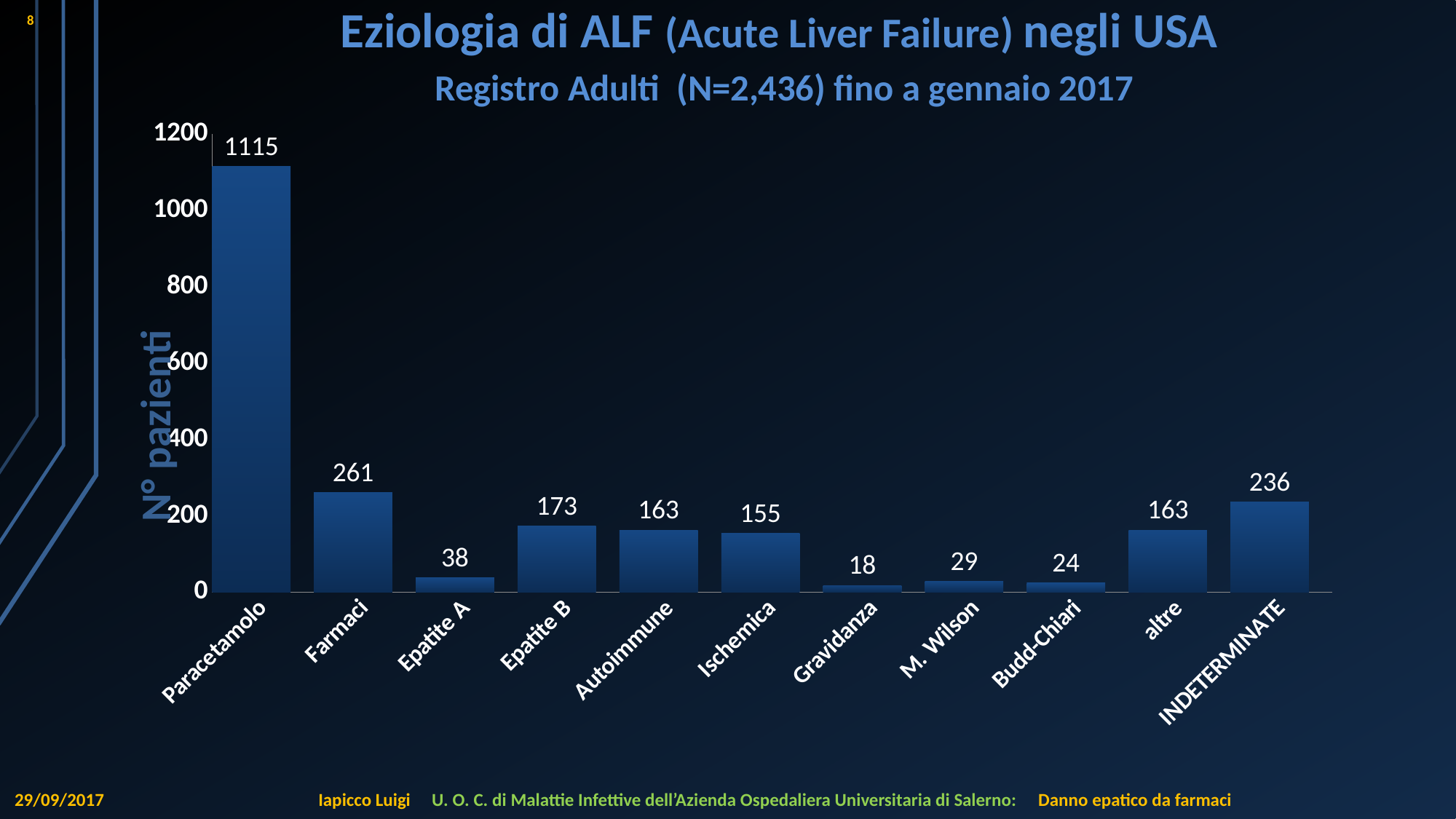
What is the label of the y axis? N° pazienti What is the value for Paracetamolo? 1115 Is the value for Paracetamolo greater or less than 1000? greater What is the difference between the values for Farmaci and INDETERMINATE? 25 Which is larger, the value for Epatite B or the value for Ischemica? Epatite B Which category has the lowest value? Gravidanza What is the value for INDETERMINATE? 236 Which category has the highest value? Paracetamolo How many categories are shown on the x axis? 11 What kind of chart is shown on the slide? bar chart What is the value for Farmaci? 261 What is the value for Gravidanza? 18